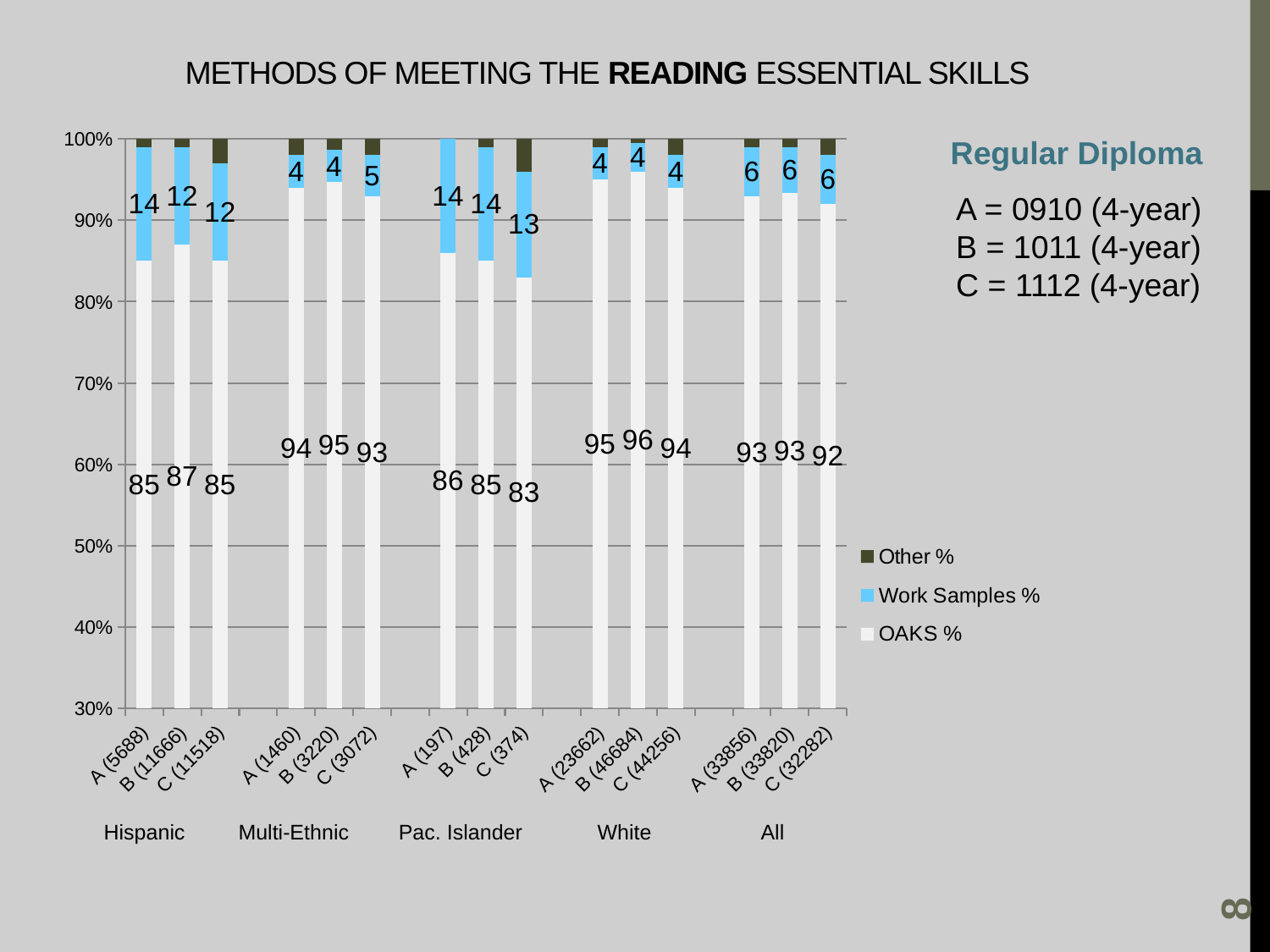
What kind of chart is shown on the slide? Stacked bar chart What is the Work Samples % value for Hispanic A (5688)? 14 How many bars are plotted in the chart? 15 Which bar has the lowest OAKS % value? Pac. Islander C (374) What is the OAKS % value for White B (46684)? 96 Which series is shown in light blue according to the legend? Work Samples % Which bar has the highest OAKS % value? White B (46684) What is the difference between the OAKS % values for Hispanic B (11666) and Hispanic A (5688)? 2 What is the OAKS % value for Pac. Islander C (374)? 83 Which is larger, the Work Samples % for Pac. Islander A (197) or for Multi-Ethnic A (1460)? Pac. Islander A (197) What is the Work Samples % value for All C (32282)? 6 How many series does the legend list? 3